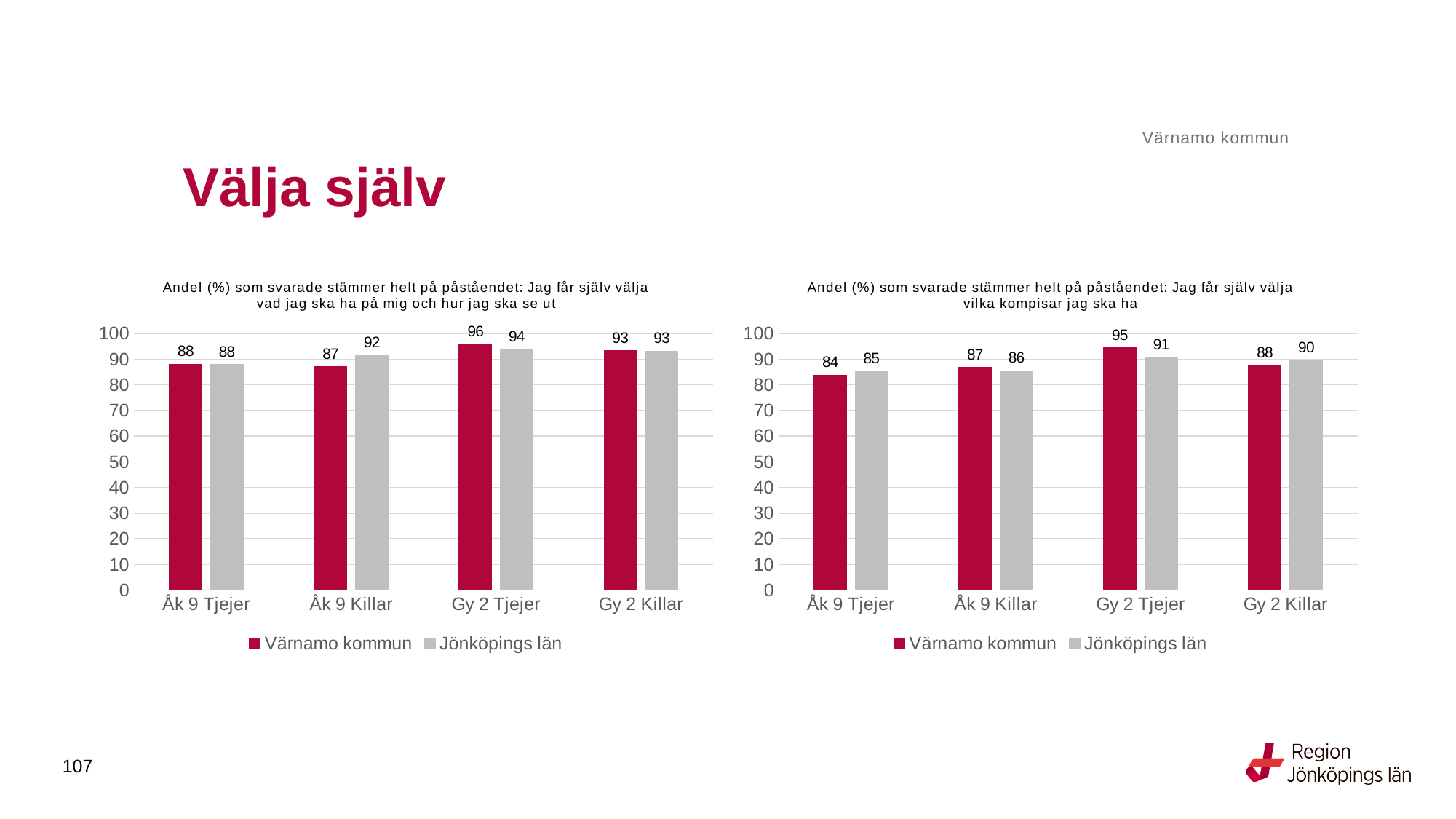
In the right chart (about choosing which friends to have), what is the difference between Värnamo kommun and Jönköpings län for Gy 2 Tjejer? 4 In the right chart (about choosing which friends to have), which category has the lowest value for Värnamo kommun? Åk 9 Tjejer In the left chart (about choosing what to wear and how to look), what is the value for Jönköpings län for Åk 9 Killar? 92 How many series does the legend of the left chart (about choosing what to wear and how to look) list? 2 How many categories are shown on the x axis of the right chart (about choosing which friends to have)? 4 In the right chart (about choosing which friends to have), what is the value for Jönköpings län for Gy 2 Killar? 90 What kind of chart is the right chart (about choosing which friends to have)? Bar chart In the right chart (about choosing which friends to have), which category has the highest value for Värnamo kommun? Gy 2 Tjejer In the left chart (about choosing what to wear and how to look), what is the value for Värnamo kommun for Gy 2 Tjejer? 96 In the left chart (about choosing what to wear and how to look), which is larger for Gy 2 Tjejer: Värnamo kommun or Jönköpings län? Värnamo kommun In the left chart (about choosing what to wear and how to look), what is the difference between Jönköpings län and Värnamo kommun for Åk 9 Killar? 5 In the right chart (about choosing which friends to have), what is the value for Värnamo kommun for Åk 9 Tjejer? 84